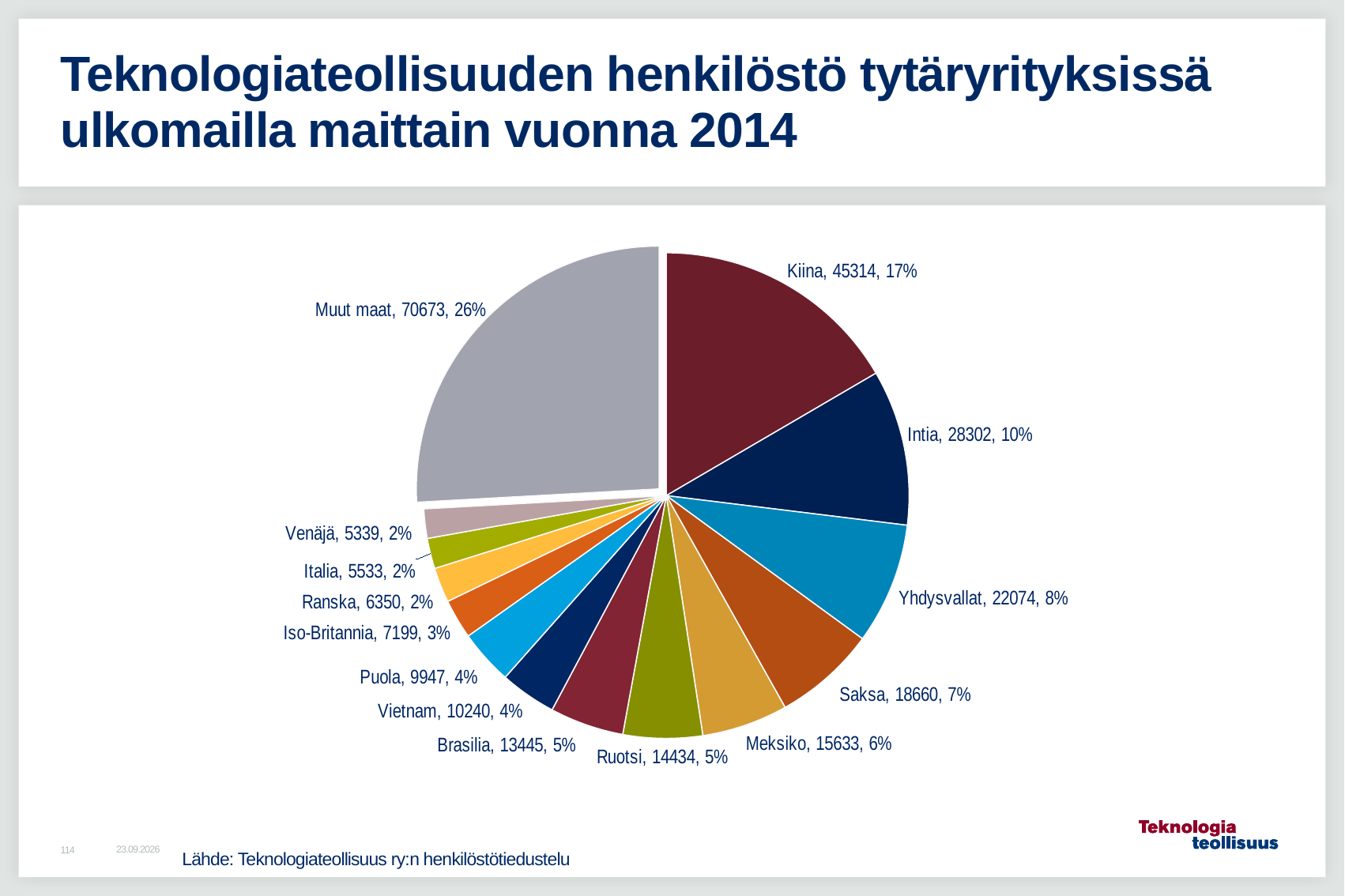
What is the value for Vietnam? 10240 What is the value for Kiina? 45314 What kind of chart is shown on the slide? pie chart What is the title of the chart on the slide? Teknologiateollisuuden henkilöstö tytäryrityksissä ulkomailla maittain vuonna 2014 Which is larger, the value for Saksa or the value for Meksiko? Saksa What share of the pie does Muut maat represent? 26% What is the difference between the values for Kiina and Intia? 17012 What is the value for Yhdysvallat? 22074 How many slices does the pie chart have? 14 What share of the pie does Intia represent? 10% Which slice is the largest? Muut maat Which slice is the smallest? Venäjä